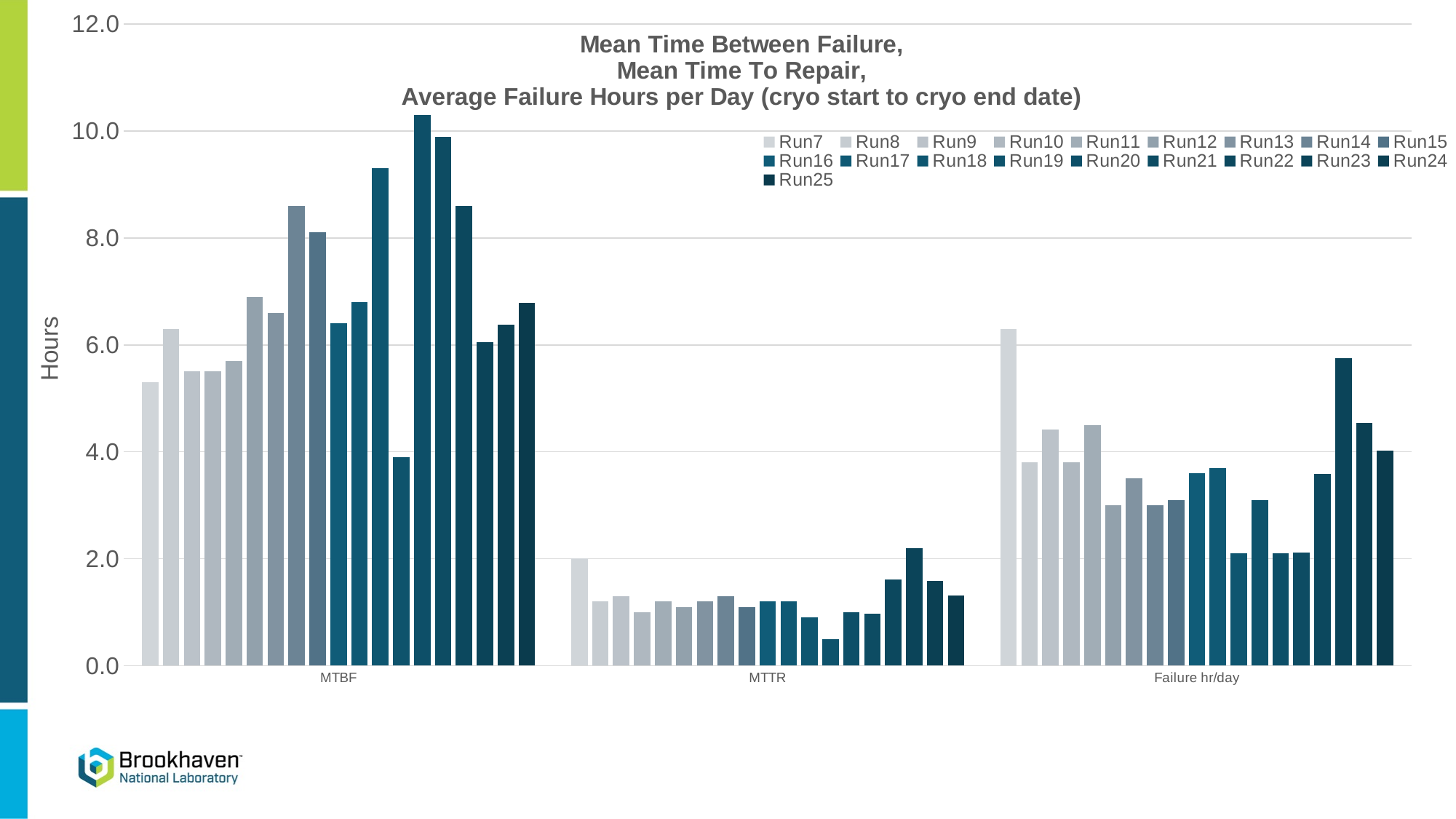
Which category contains the tallest bar in the chart? MTBF Which category has the lowest bars overall? MTTR Is the tallest bar in the Failure hr/day group larger or smaller than the tallest bar in the MTBF group? smaller What kind of chart is shown on the slide? bar chart How many categories are shown on the x axis of the chart? 3 Is the leftmost (Run7) bar in the Failure hr/day group greater or less than 6.0? greater Is the leftmost (Run7) bar in the MTBF group greater or less than 6.0? less Is the tallest bar in the MTTR group greater or less than 4.0? less What is the label of the y axis? Hours What is the first series listed in the legend? Run7 How many series does the chart's legend list? 19